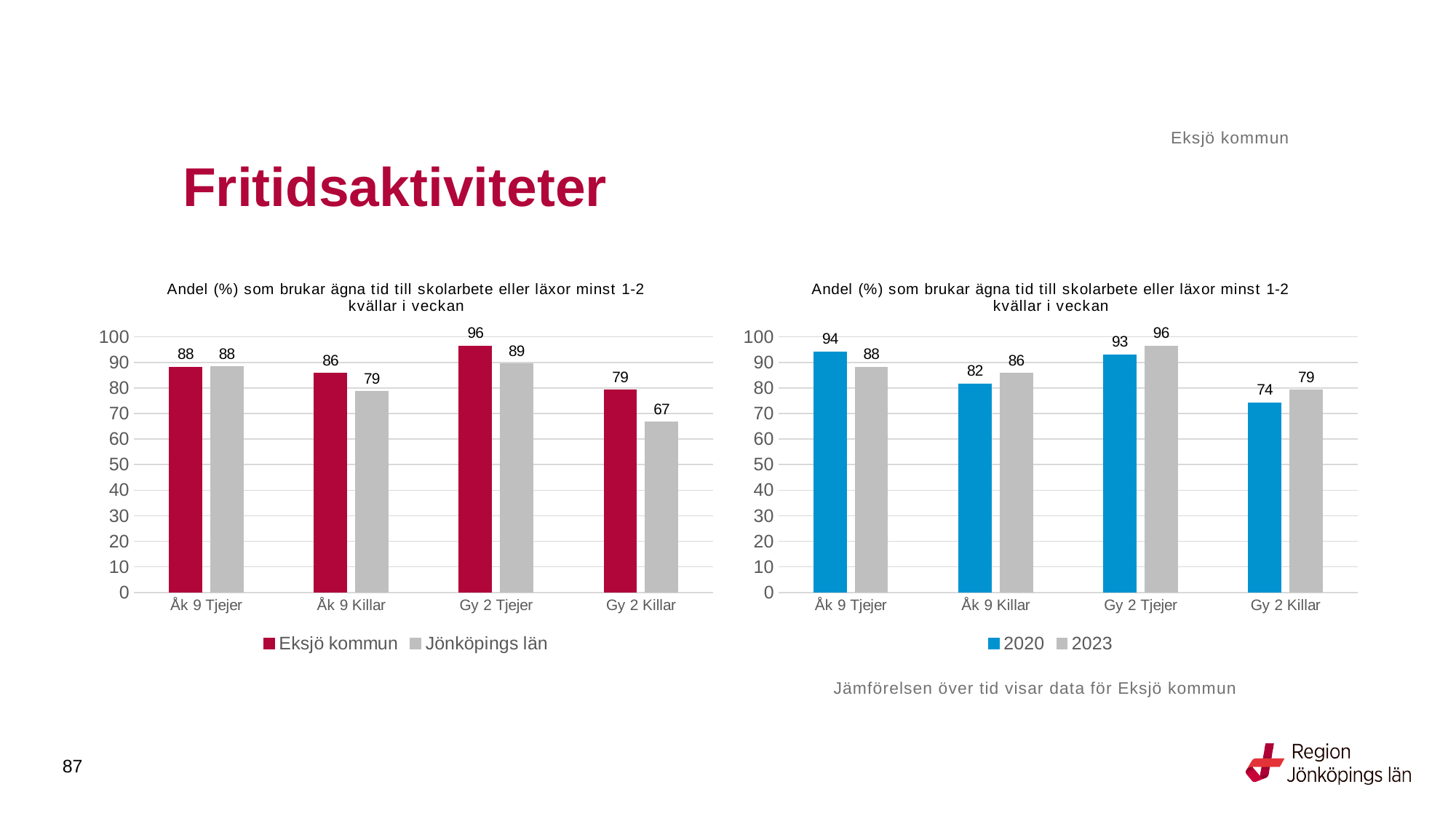
In the left chart, what is the difference between Eksjö kommun and Jönköpings län for Gy 2 Killar? 12 In the right chart, what is the difference between 2020 and 2023 for Åk 9 Tjejer? 6 In the right chart, what is the value for 2023 for Gy 2 Killar? 79 In the left chart, what is the value for Jönköpings län for Gy 2 Killar? 67 What kind of chart is the left chart? Bar chart How many series does the legend of the right chart list? 2 In the right chart, which category has the highest value for 2023? Gy 2 Tjejer In the left chart, which is larger for Åk 9 Killar: Eksjö kommun or Jönköpings län? Eksjö kommun In the left chart, what is the value for Eksjö kommun for Gy 2 Tjejer? 96 In the left chart, which category has the lowest value for Jönköpings län? Gy 2 Killar In the right chart, what is the value for 2020 for Åk 9 Tjejer? 94 In the right chart, which is larger for Gy 2 Tjejer: 2020 or 2023? 2023